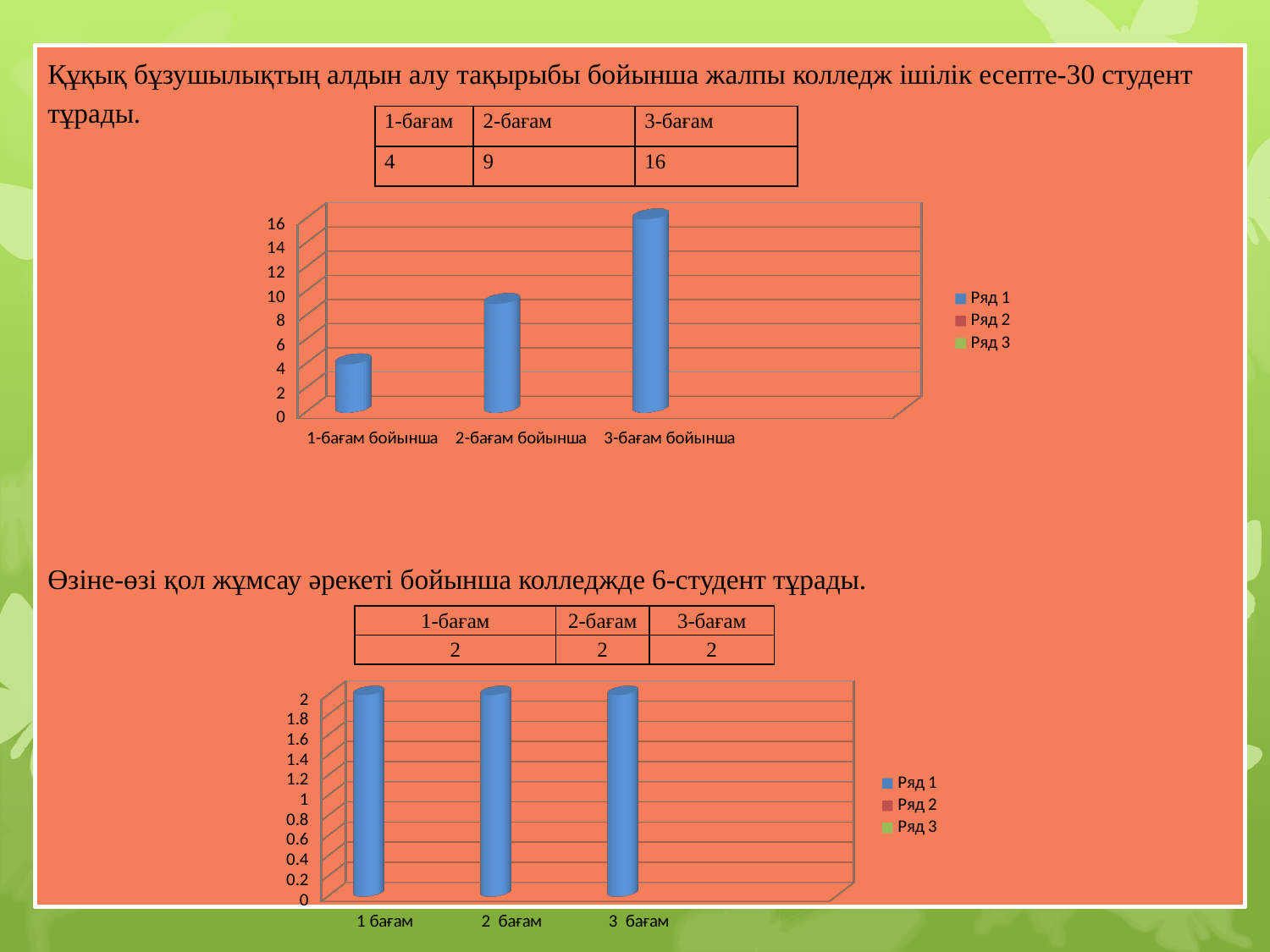
In the top chart, what is the value for 3-бағам бойынша? 16 In the top chart, is the value for 2-бағам бойынша greater or less than 6? greater In the top chart, which is larger: the value for 2-бағам бойынша or 1-бағам бойынша? 2-бағам бойынша How many categories are shown in the top chart? 3 What kind of chart is the bottom chart? bar chart In the top chart, which category has the highest value? 3-бағам бойынша In the top chart, do the values rise or fall from left to right along the x axis? rise In the top chart, which category has the lowest value? 1-бағам бойынша In the bottom chart, what is the value for 2 бағам? 2 In the top chart, what is the difference between the values for 3-бағам бойынша and 2-бағам бойынша? 7 In the top chart, what is the value for 1-бағам бойынша? 4 How many series does the legend of the bottom chart list? 3